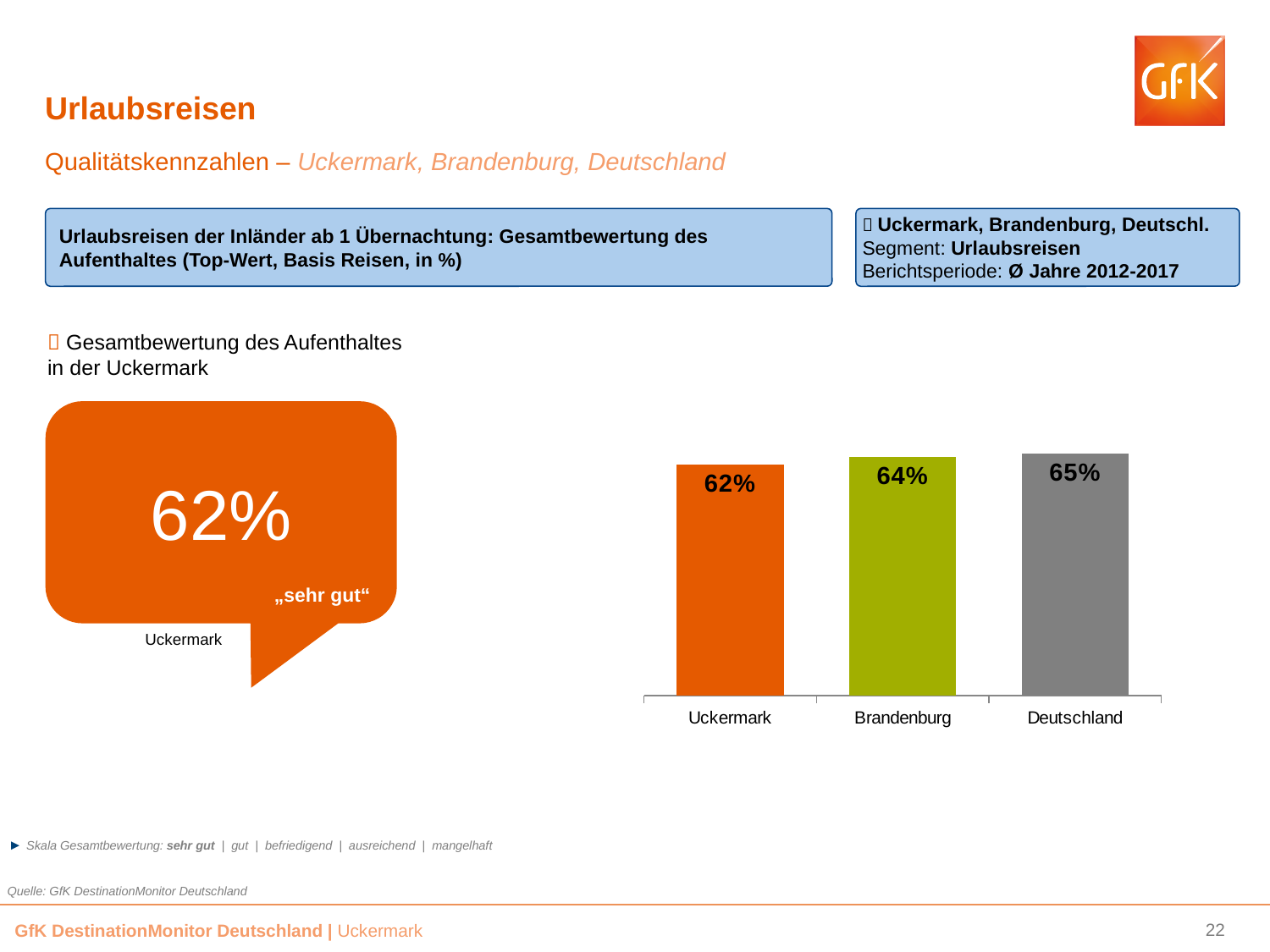
Which category has the lowest value in the bar chart? Uckermark What colour is the bar for Brandenburg? Green What is the difference between the values for Brandenburg and Uckermark? 2 percentage points Which is larger, the value for Brandenburg or the value for Deutschland? Deutschland What is the difference between the values for Deutschland and Uckermark? 3 percentage points What is the value for Uckermark in the bar chart? 62% What is the value for Brandenburg in the bar chart? 64% Do the values rise or fall from Uckermark to Deutschland along the x axis? Rise How many categories are shown in the bar chart? 3 What is the value for Deutschland in the bar chart? 65% What kind of chart is shown on the slide? Bar chart Which category has the highest value in the bar chart? Deutschland